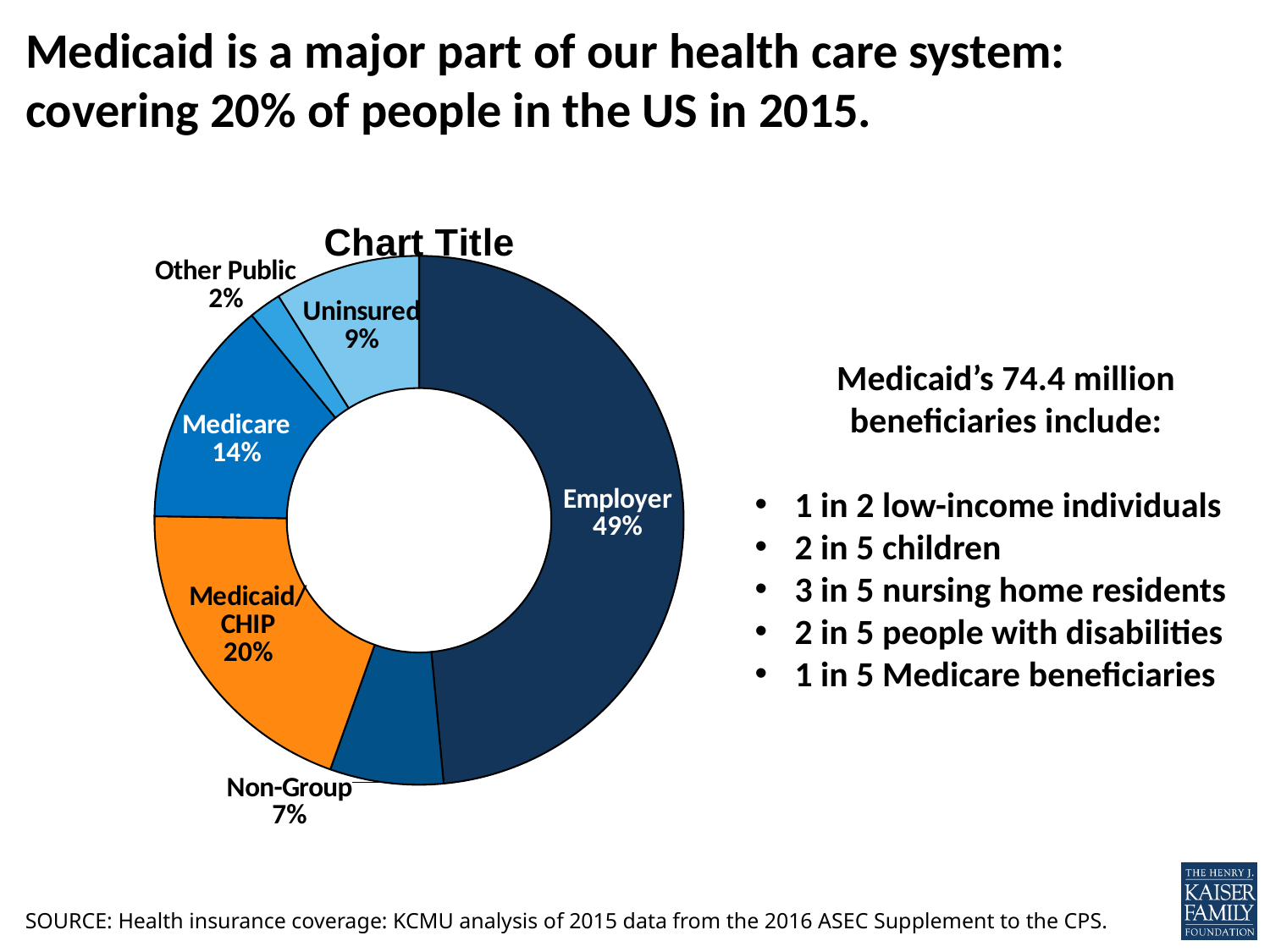
Which category has the smallest share of the chart? Other Public What is the difference in percentage points between Medicaid/CHIP and Medicare? 6 How many categories are shown in the chart? 6 What title is displayed above the chart? Chart Title What share of the chart does Employer coverage account for? 49% What is the value shown for Non-Group? 7% Which category has the largest share of the chart? Employer What is the value shown for Medicaid/CHIP? 20% What is the value shown for Uninsured? 9% What is the value shown for Medicare? 14% Which is larger, the share for Uninsured or the share for Non-Group? Uninsured What kind of chart is shown on the slide? doughnut chart